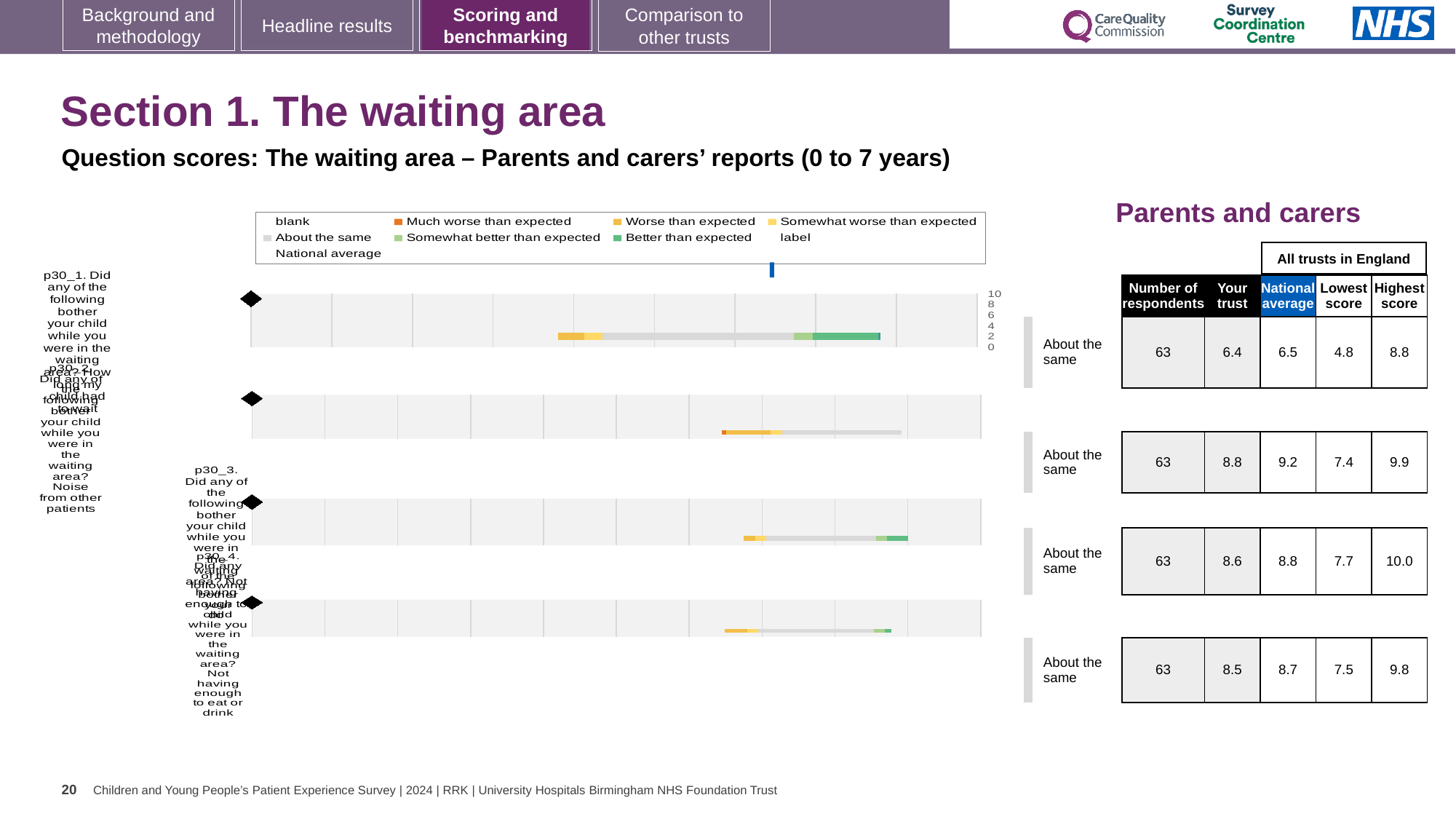
What kind of chart is shown on the slide? bar chart In the table, what is the 'Your trust' score for the second question row? 8.8 Which question row has the highest 'Your trust' score in the table? the second row (8.8) In the table, what is the lowest score for the second question row? 7.4 What benchmark category is shown next to each of the four question rows? About the same For the first question row, what is the difference between the national average and the 'Your trust' score? 0.1 In the table, what is the national average for the third question row? 8.8 How many question rows (bars) are plotted in the chart? 4 In the table, what is the highest score for the fourth question row? 9.8 Which question row has the lowest 'Your trust' score in the table? the first row (6.4) For the first question row, is the 'Your trust' score higher or lower than the national average? lower In the table, what is the number of respondents for the first question row? 63